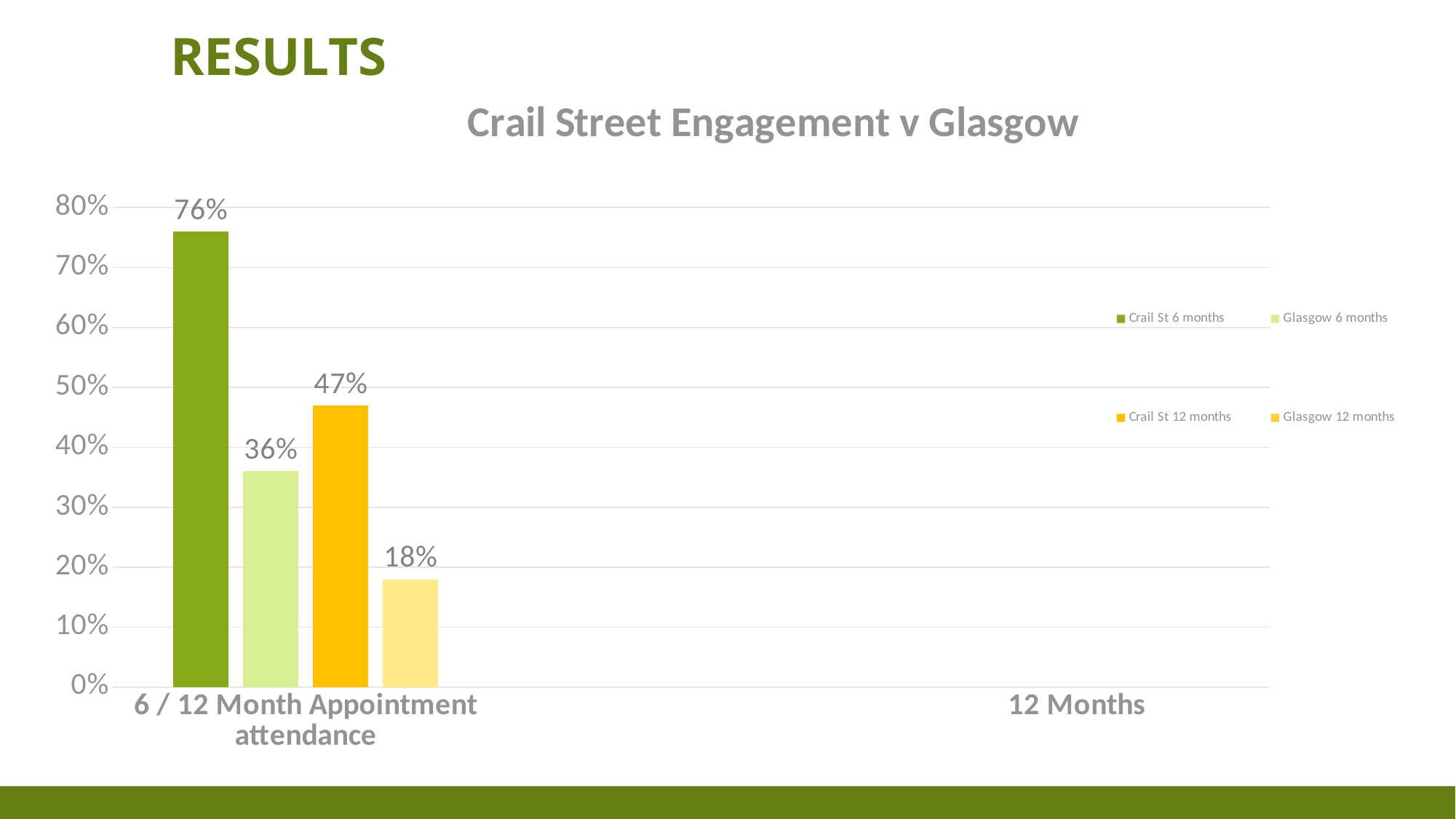
Which is larger, the Crail St 12 months value or the Glasgow 6 months value? Crail St 12 months What is the difference between the Crail St 12 months value and the Glasgow 12 months value? 29% What is the difference between the Crail St 6 months value and the Glasgow 6 months value? 40% What is the value for Crail St 12 months in the 6 / 12 Month Appointment attendance category? 47% What is the title of the chart? Crail Street Engagement v Glasgow What is the value for Crail St 6 months in the 6 / 12 Month Appointment attendance category? 76% How many series does the legend list? 4 What kind of chart is shown on the slide? Bar chart Which series has the lowest value in the 6 / 12 Month Appointment attendance category? Glasgow 12 months What is the value for Glasgow 6 months in the 6 / 12 Month Appointment attendance category? 36% Which series has the highest value in the 6 / 12 Month Appointment attendance category? Crail St 6 months What is the value for Glasgow 12 months in the 6 / 12 Month Appointment attendance category? 18%